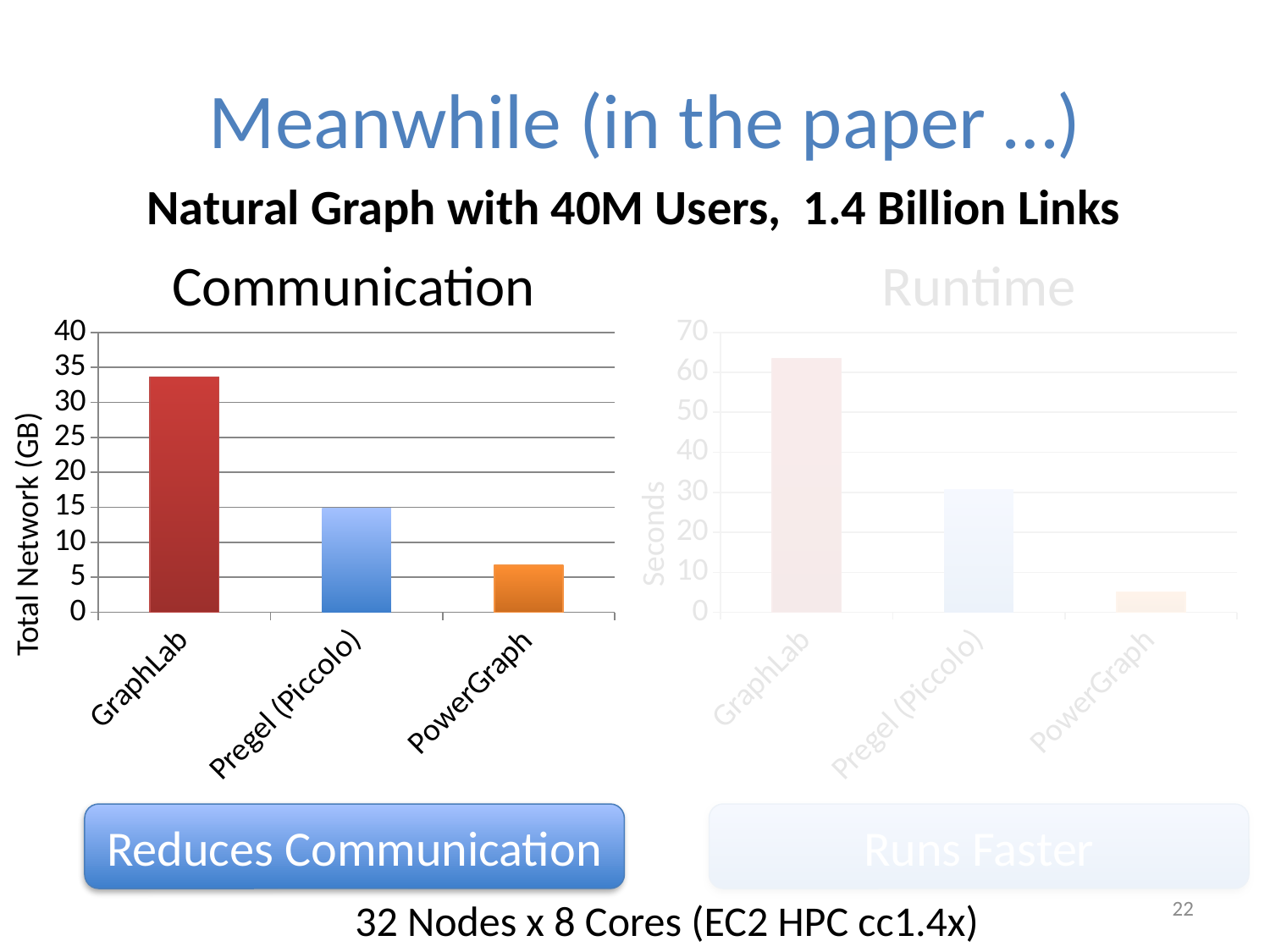
In the Runtime chart, which category has the highest value? GraphLab In the Communication chart, is the value for Pregel (Piccolo) greater or less than 20? less How many categories are shown in the Communication chart? 3 In the Communication chart, which category has the lowest value? PowerGraph In the Communication chart, is the value for GraphLab greater or less than 30? greater In the Communication chart, is the value for PowerGraph greater or less than 10? less What kind of chart is the Communication chart? bar chart In the Communication chart, which category has the highest value? GraphLab In the Communication chart, which is larger, the value for Pregel (Piccolo) or the value for PowerGraph? Pregel (Piccolo) What is the y-axis title of the Communication chart? Total Network (GB) In the Communication chart, do the values rise or fall from left to right along the x axis? fall